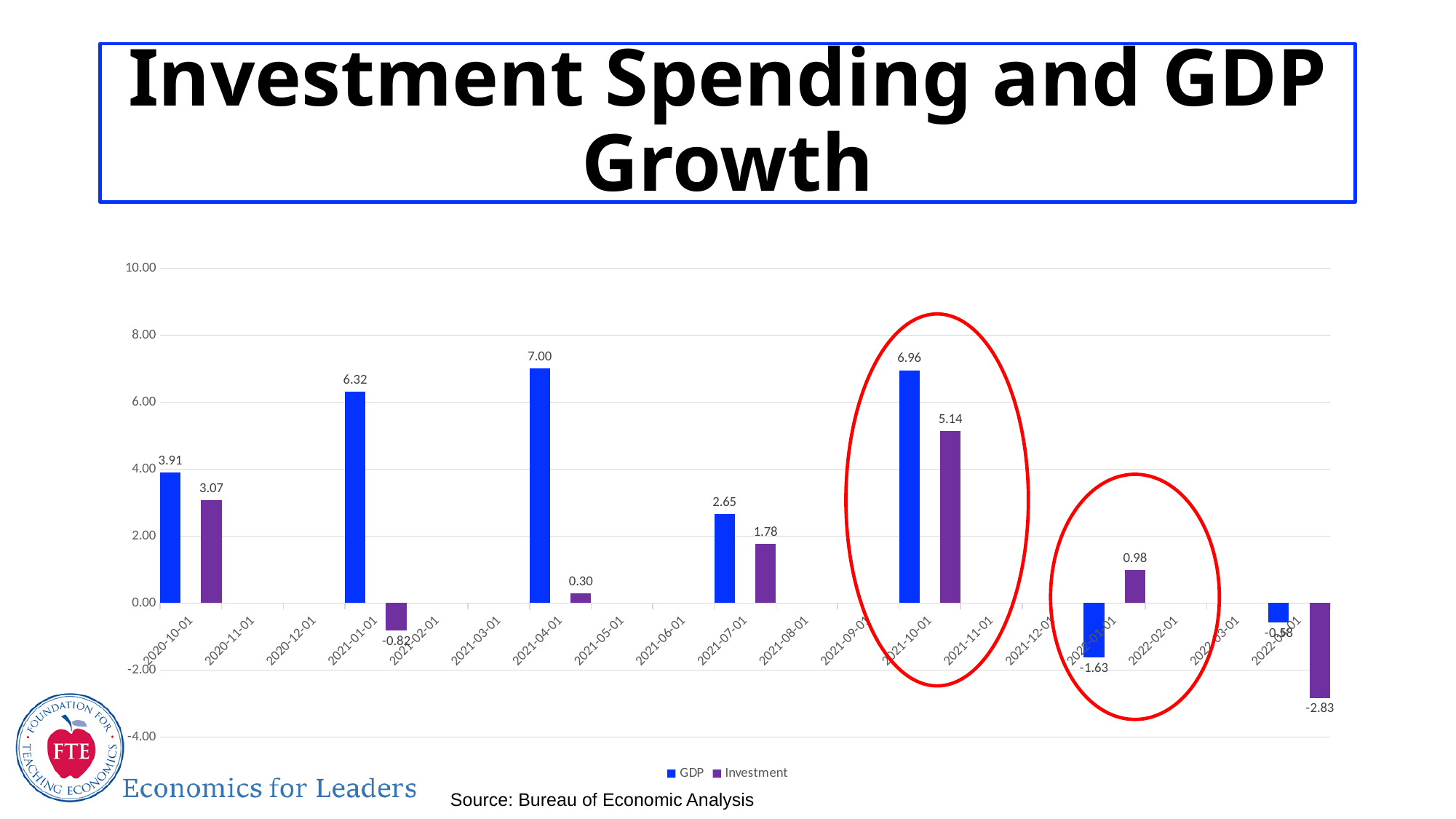
What is the difference between the GDP and Investment values for 2020-10-01? 0.84 What is the GDP value for 2020-10-01? 3.91 What is the lowest Investment value shown on the chart? -2.83 How many series does the legend list? 2 What kind of chart is shown on the slide? Bar chart Which is larger, the GDP value for 2021-01-01 or the GDP value for 2021-04-01? 2021-04-01 What is the difference between the GDP and Investment values for 2021-10-01? 1.82 What is the Investment value for 2021-04-01? 0.30 Which date has the highest GDP value? 2021-04-01 What is the Investment value for 2021-10-01? 5.14 What is the Investment value for 2021-01-01? -0.82 What is the GDP value for 2022-01-01? -1.63